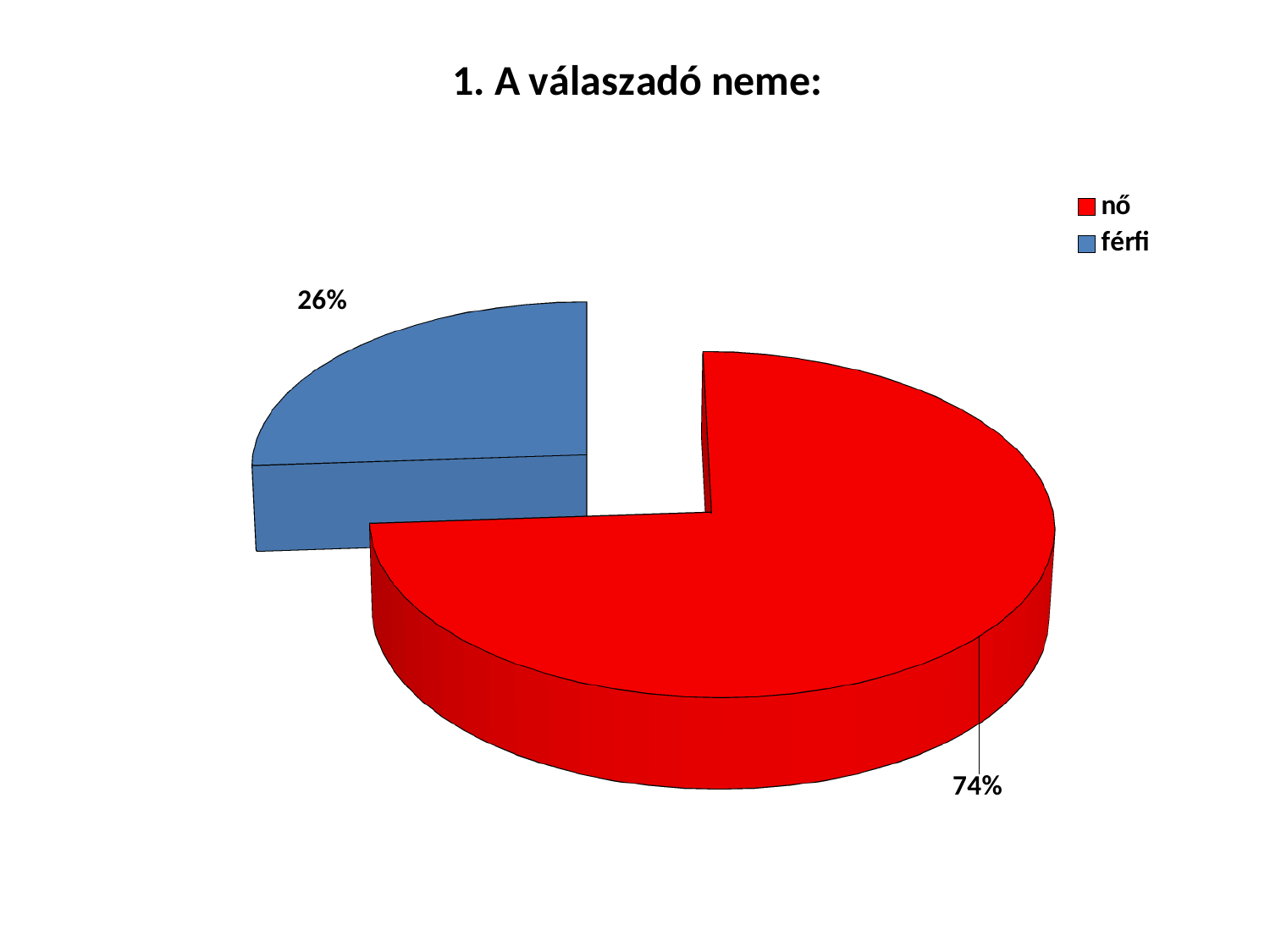
What colour is the "férfi" slice? blue What share of the pie does the "férfi" slice represent? 26% How many entries does the legend list? 2 What kind of chart is shown on the slide? pie chart Which slice is larger, "nő" or "férfi"? nő How many slices does the pie chart have? 2 Which category has the smallest slice of the pie? férfi What is the title of the chart? 1. A válaszadó neme: What share of the pie does the "nő" slice represent? 74% What is the difference in percentage points between the "nő" and "férfi" slices? 48 Which category has the largest slice of the pie? nő Is the share for "nő" greater or less than 50%? greater